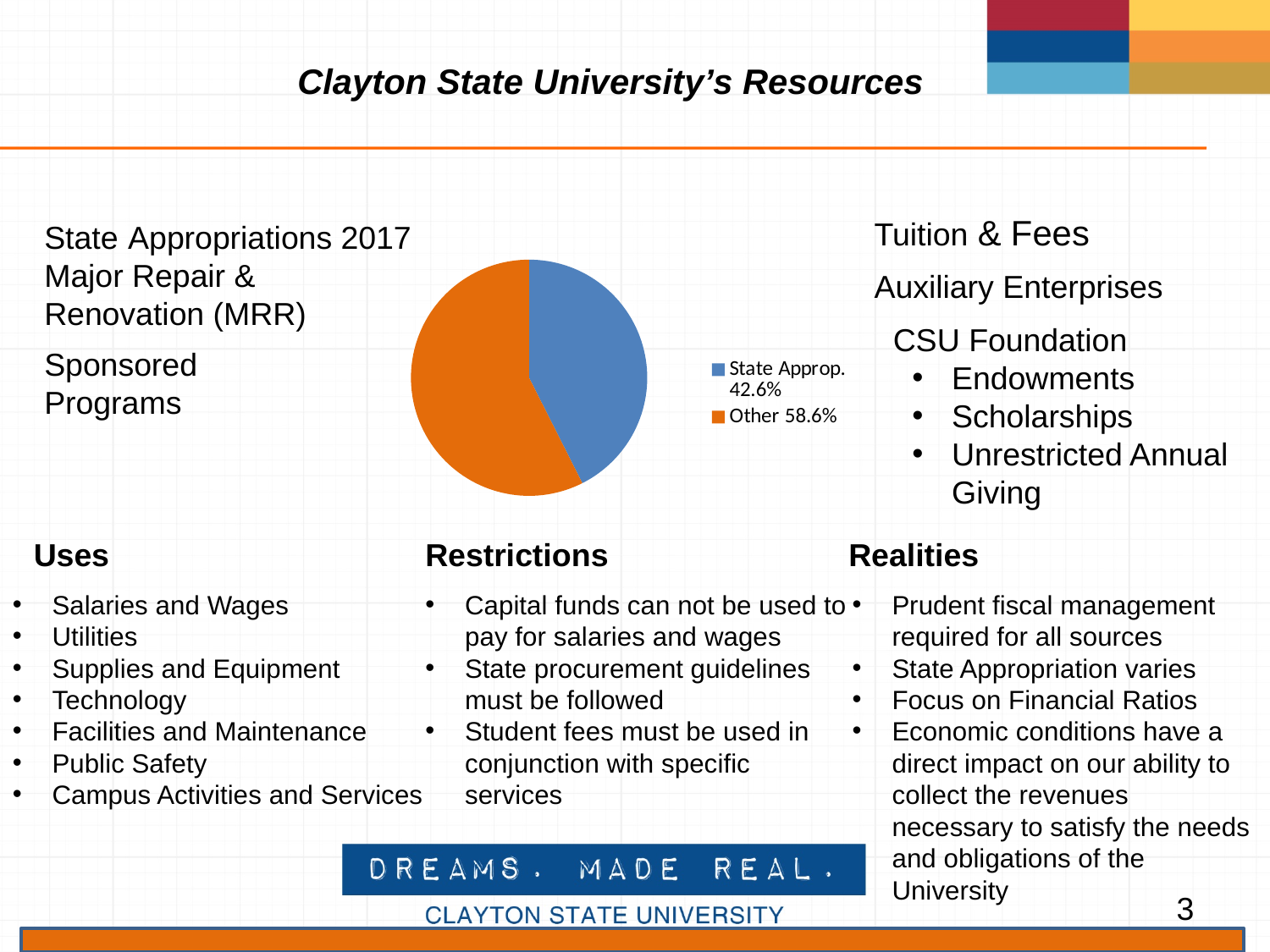
What colour is the Other slice in the pie chart? Orange How many entries does the pie chart's legend list? 2 Which slice of the pie chart is the smallest? State Approp. How many slices does the pie chart have? 2 Is the State Approp. share in the pie chart greater or less than 50%? less Which is larger in the pie chart, State Approp. or Other? Other What type of chart is shown on the slide? Pie chart What percentage does the legend give for Other in the pie chart? 58.6% What share of the pie chart does State Approp. represent? 42.6% Which slice of the pie chart is the largest? Other What percentage does the legend give for State Approp. in the pie chart? 42.6% By how many percentage points does Other exceed State Approp. in the pie chart? 16.0 percentage points